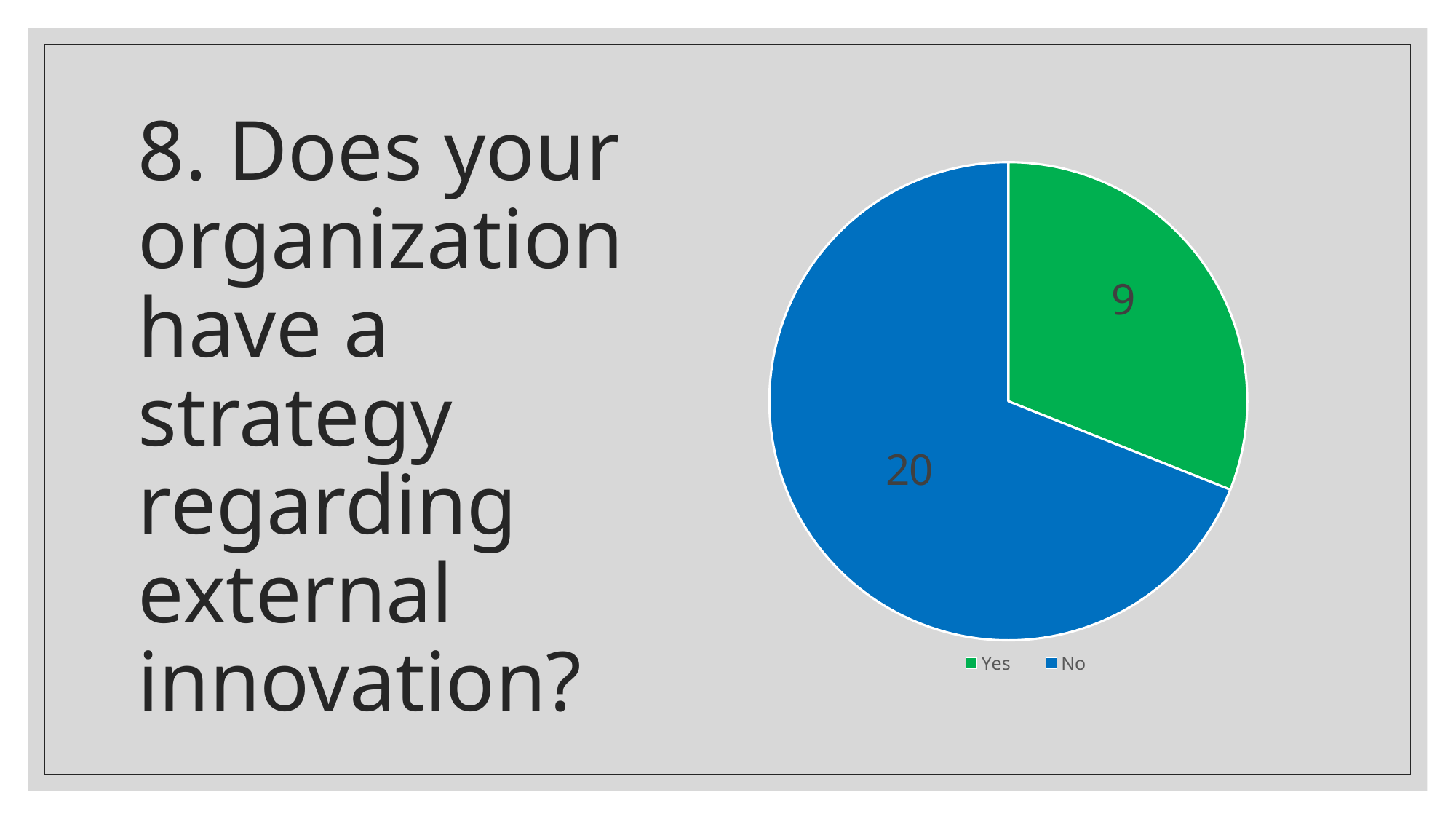
Which category has the smallest slice? Yes How many slices does the pie chart have? 2 Which is larger, Yes or No? No What is the value for No? 20 What colour is the No slice? blue How many entries does the legend list? 2 What is the value for Yes? 9 What colour is the Yes slice? green What kind of chart is shown on the slide? pie chart What is the difference between the No and Yes values? 11 What is the total of all slices in the pie chart? 29 Which category has the largest slice? No